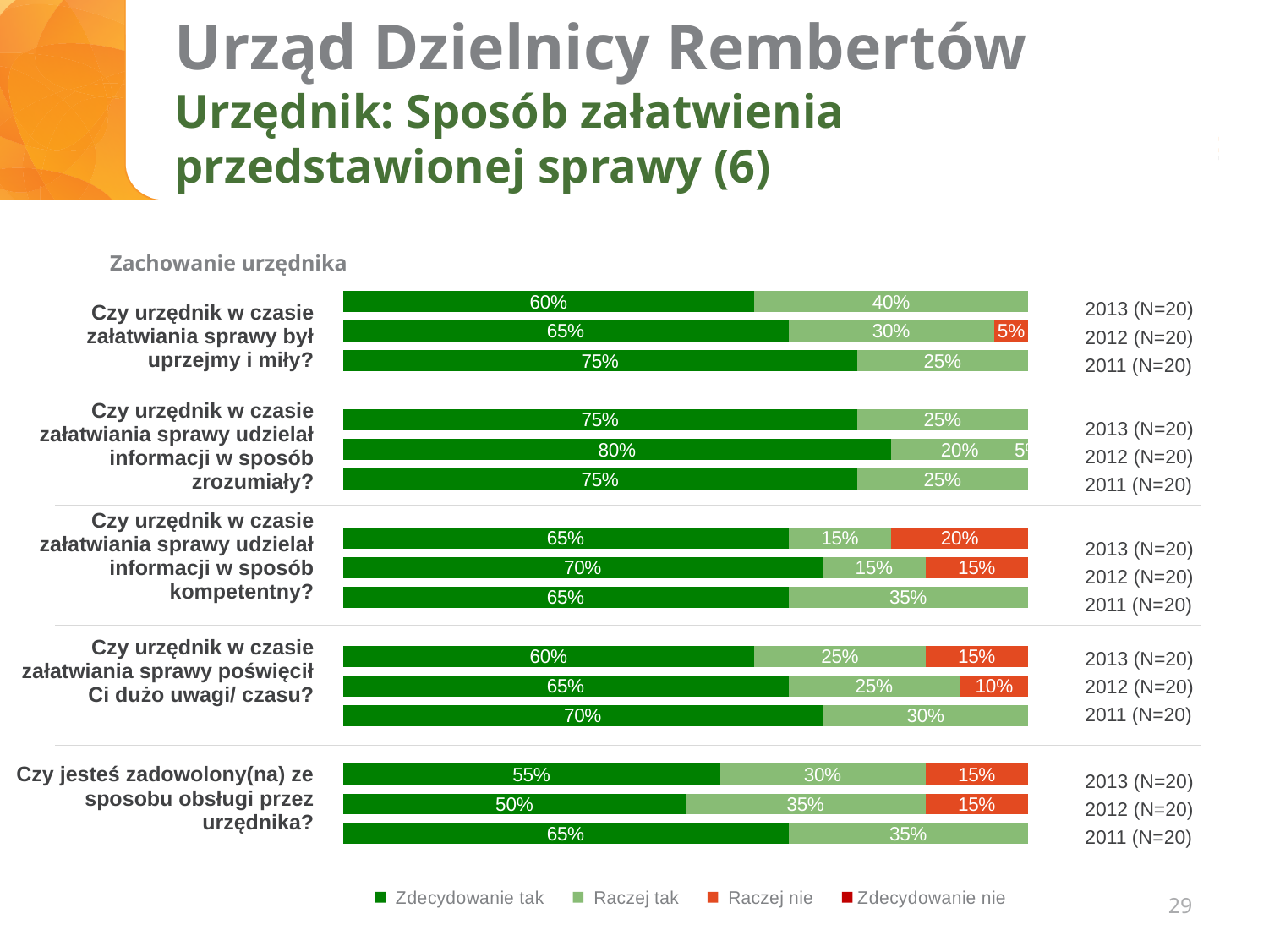
How many series does the legend list? 4 For the question "Czy urzędnik w czasie załatwiania sprawy był uprzejmy i miły?", which year has the highest "Zdecydowanie tak" share? 2011 For the question "Czy urzędnik w czasie załatwiania sprawy poświęcił Ci dużo uwagi/ czasu?", is the "Raczej nie" share larger in 2013 or in 2012? 2013 For the question "Czy jesteś zadowolony(na) ze sposobu obsługi przez urzędnika?", which year has the lowest "Zdecydowanie tak" share? 2012 What percentage answered "Raczej nie" in 2013 to the question "Czy urzędnik w czasie załatwiania sprawy udzielał informacji w sposób kompetentny?"? 20% What percentage answered "Zdecydowanie tak" in 2012 to the question "Czy urzędnik w czasie załatwiania sprawy udzielał informacji w sposób zrozumiały?"? 80% What is the difference between the "Zdecydowanie tak" shares for 2011 and 2013 for the question "Czy urzędnik w czasie załatwiania sprawy był uprzejmy i miły?"? 15% What is the sample size (N) shown for each year in the chart? N=20 What percentage answered "Zdecydowanie tak" in 2013 to the question "Czy urzędnik w czasie załatwiania sprawy był uprzejmy i miły?"? 60% What kind of chart is shown on the slide? Stacked bar chart How many survey questions are shown in the chart? 5 What percentage answered "Raczej tak" in 2011 to the question "Czy jesteś zadowolony(na) ze sposobu obsługi przez urzędnika?"? 35%